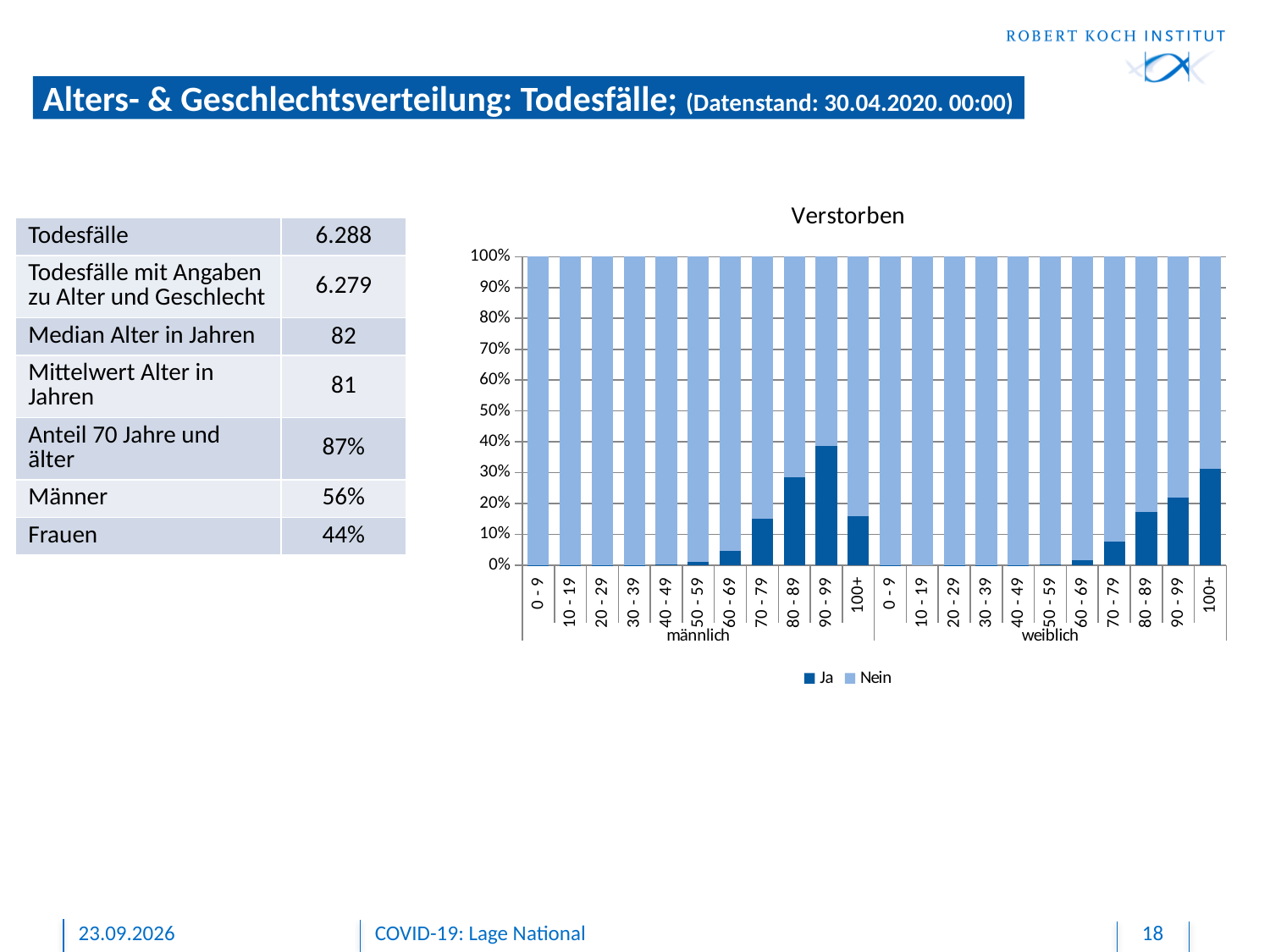
Which bar has the largest 'Ja' share in the chart? männlich 90 - 99 How many bars (age-group categories) are plotted in the chart in total? 22 Is the 'Ja' share for weiblich 70 - 79 greater or less than 10%? less Which has the larger 'Ja' share: männlich 90 - 99 or weiblich 90 - 99? männlich 90 - 99 What is the title of the chart? Verstorben Which has the larger 'Ja' share: männlich 100+ or weiblich 100+? weiblich 100+ What kind of chart is shown on the slide? Stacked bar chart Is the 'Ja' share for männlich 80 - 89 greater or less than 30%? less Is the 'Ja' share for weiblich 80 - 89 greater or less than 20%? less What are the two series named in the legend? Ja and Nein How many series does the chart legend list? 2